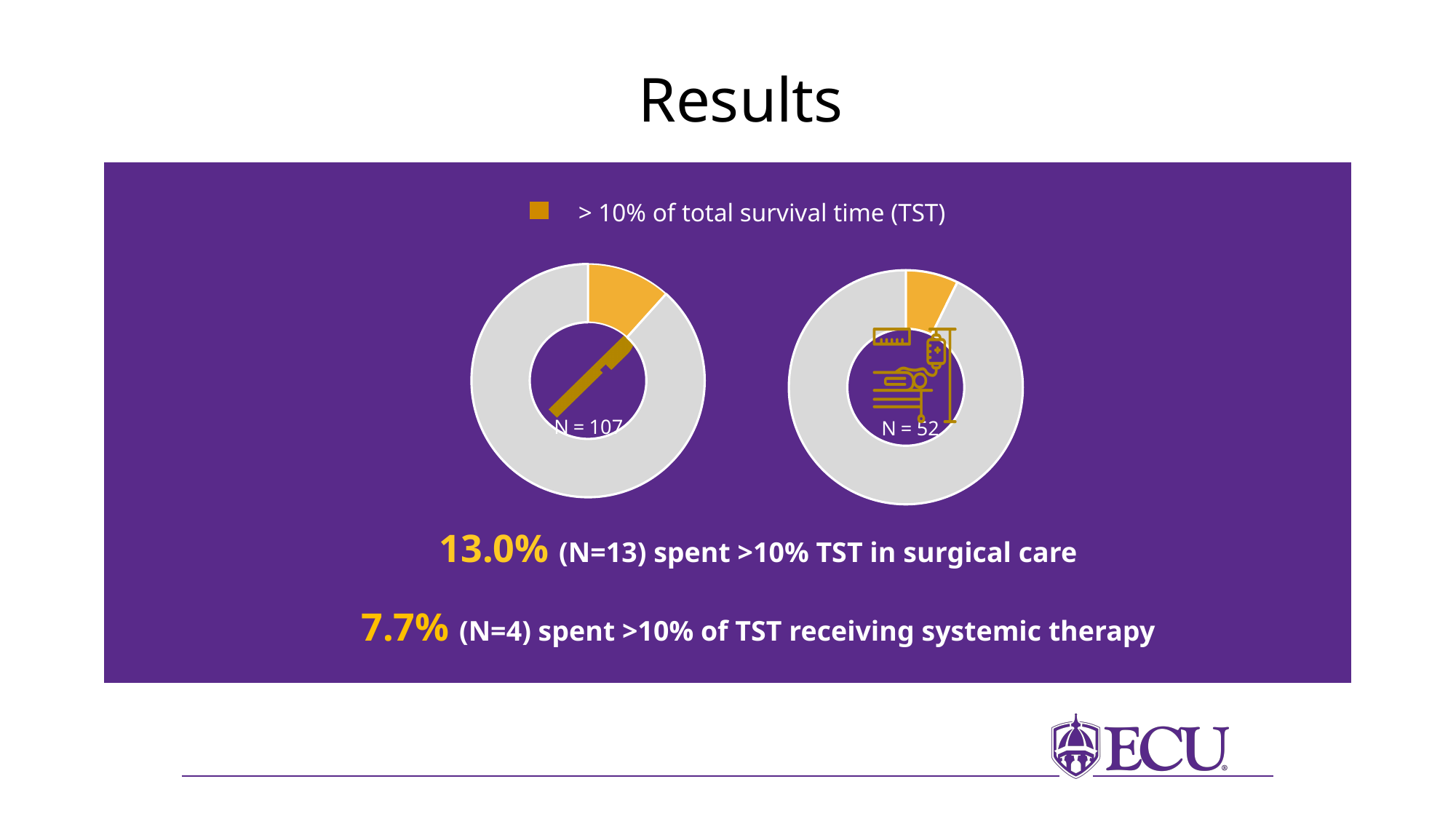
Which is larger: the share spending >10% TST in surgical care or the share spending >10% TST receiving systemic therapy? Surgical care What percentage of patients spent >10% of TST in surgical care? 13.0% How many patients (N) spent >10% of TST receiving systemic therapy? 4 What is the N value printed in the centre of the left donut chart? N = 107 How many patients (N) spent >10% TST in surgical care? 13 What is the N value printed in the centre of the right donut chart? N = 52 What type of chart is shown on the left of the slide? Donut chart What percentage of patients spent >10% of TST receiving systemic therapy? 7.7% What does the orange legend entry above the donut charts represent? > 10% of total survival time (TST) What is the difference in percentage points between the surgical care share (13.0%) and the systemic therapy share (7.7%)? 5.3 Which donut chart has the larger total N, the left (surgical care) or the right (systemic therapy)? Left (surgical care) How many donut charts are shown on the slide? 2